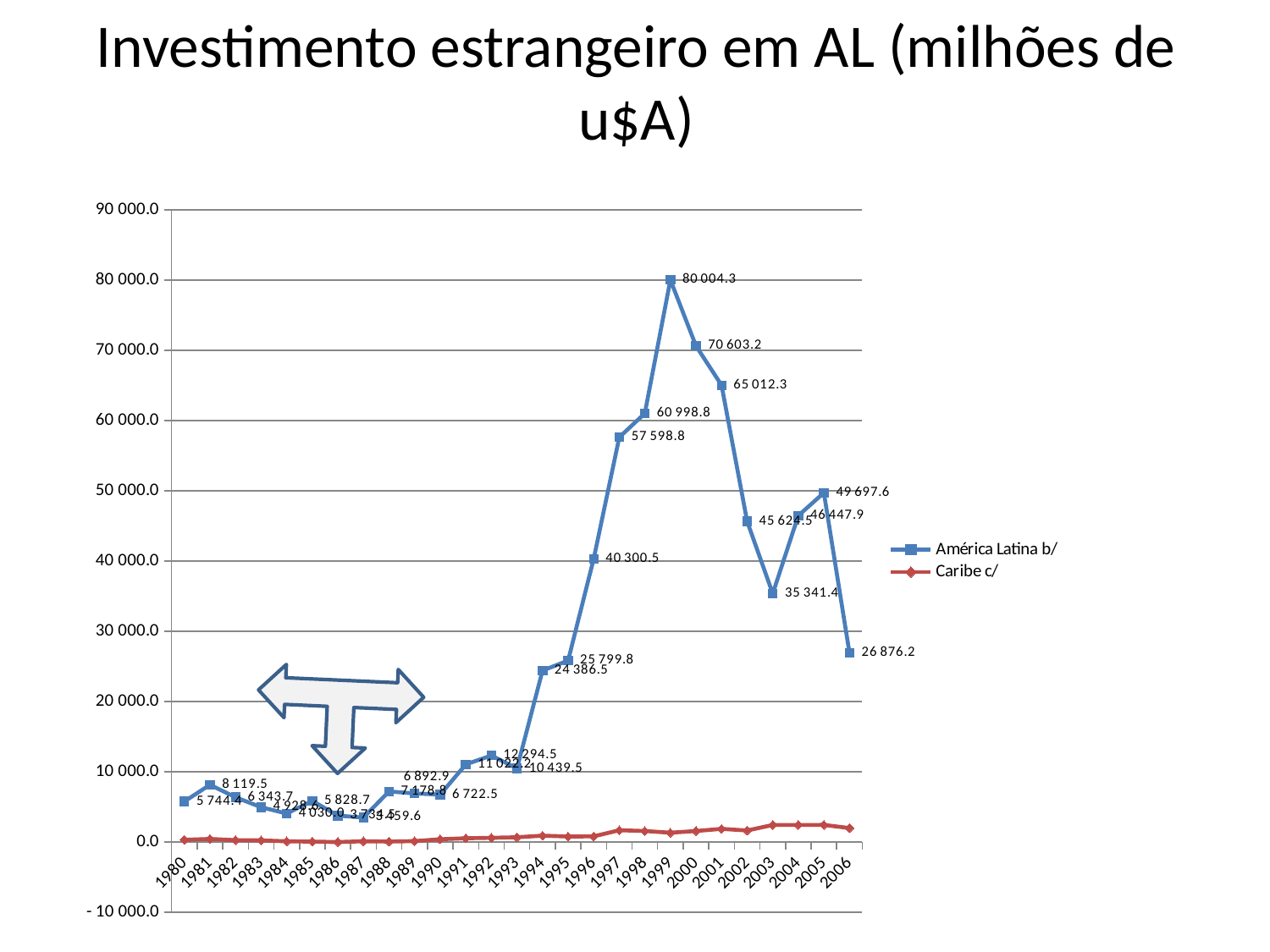
In which year does the América Latina b/ series reach its highest value? 1999 Which year has the larger América Latina b/ value, 2004 or 2005? 2005 Is the value for Caribe c/ in 2006 greater or less than 10 000.0? less What is the value of América Latina b/ in 1996? 40 300.5 How many years are plotted along the x axis? 27 What is the value of América Latina b/ in 1999? 80 004.3 How many series does the legend list? 2 Which series are listed in the legend? América Latina b/ and Caribe c/ What is the value of América Latina b/ in 2003? 35 341.4 What kind of chart is shown on the slide? line chart What is the difference between the América Latina b/ values for 1999 and 2000? 9 401.1 What is the value of América Latina b/ in 2006? 26 876.2